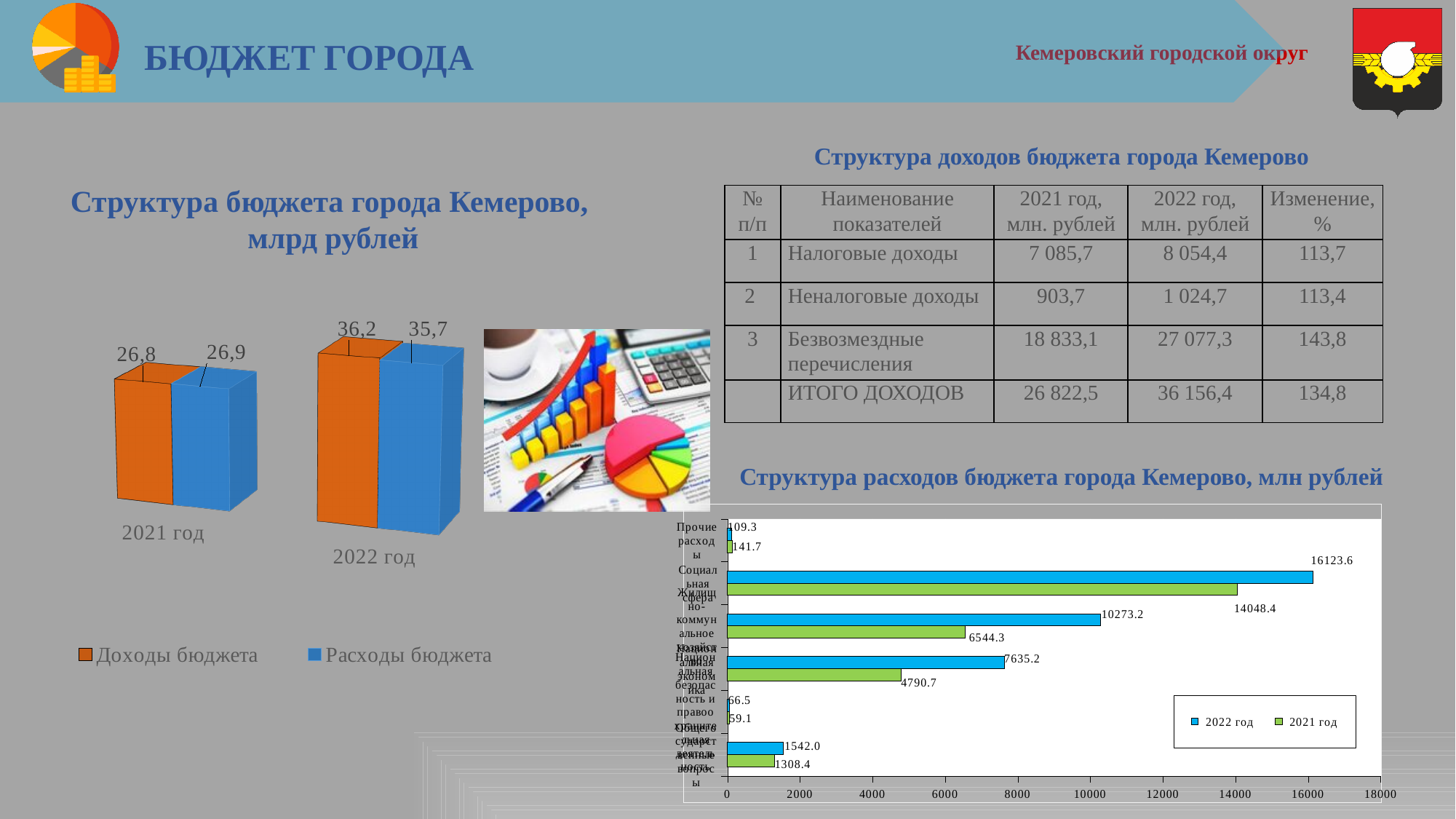
In the chart 'Структура бюджета города Кемерово, млрд рублей', what is the value of Расходы бюджета for 2022 год? 35,7 In the chart 'Структура расходов бюджета города Кемерово, млн рублей', what is the value for Социальная сфера in 2022 год? 16123.6 In the chart 'Структура расходов бюджета города Кемерово, млн рублей', what colour are the bars for 2021 год? green In the chart 'Структура бюджета города Кемерово, млрд рублей', what is the value of Доходы бюджета for 2021 год? 26,8 In the chart 'Структура расходов бюджета города Кемерово, млн рублей', what is the difference between the 2022 год and 2021 год values for Социальная сфера? 2075.2 In the chart 'Структура бюджета города Кемерово, млрд рублей', how many series does the legend list? 2 What kind of chart is 'Структура расходов бюджета города Кемерово, млн рублей'? bar chart In the chart 'Структура расходов бюджета города Кемерово, млн рублей', what is the value for Прочие расходы in 2021 год? 141.7 In the chart 'Структура бюджета города Кемерово, млрд рублей', do the values of Доходы бюджета rise or fall from 2021 год to 2022 год? rise In the chart 'Структура бюджета города Кемерово, млрд рублей', what is the difference between Доходы бюджета in 2022 год and 2021 год? 9,4 In the chart 'Структура расходов бюджета города Кемерово, млн рублей', which category has the highest value for 2022 год? Социальная сфера In the chart 'Структура бюджета города Кемерово, млрд рублей', which is larger for 2022 год: Доходы бюджета or Расходы бюджета? Доходы бюджета